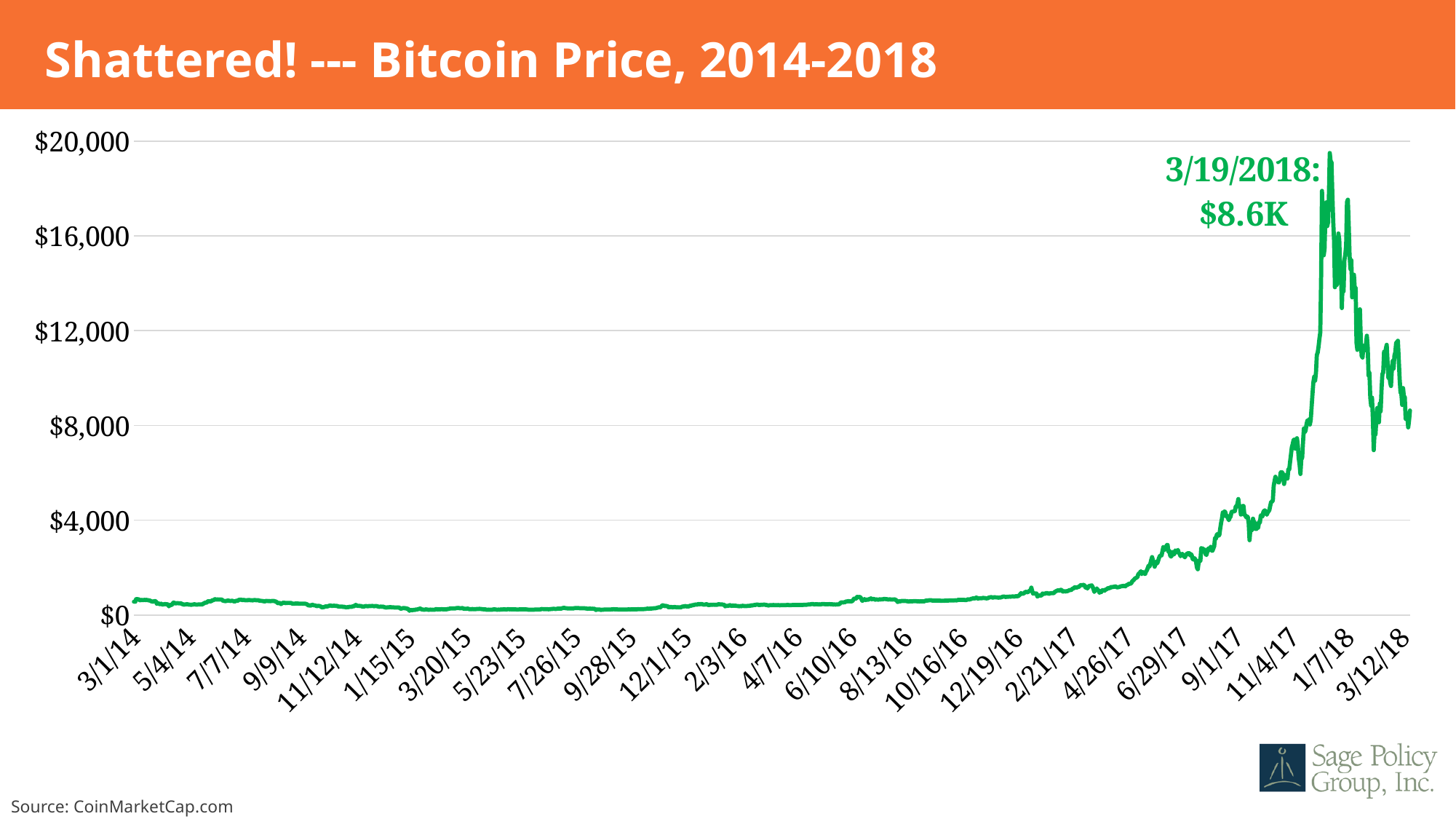
Is the Bitcoin price at 1/7/18 greater or less than $12,000? greater Does the Bitcoin price rise or fall from 1/7/18 to 3/12/18? fall Is the Bitcoin price at 9/1/17 greater or less than $8,000? less What kind of chart is shown on the slide? line chart Is the Bitcoin price at 6/29/17 greater or less than $4,000? less Does the Bitcoin price generally rise or fall from 3/1/14 to 1/7/18? rise What Bitcoin price is annotated on the chart for 3/19/2018? $8.6K What is the title of the chart? Shattered! --- Bitcoin Price, 2014-2018 Which is larger, the Bitcoin price at 3/12/18 or at 3/1/14? 3/12/18 What is the highest value labelled on the y axis? $20,000